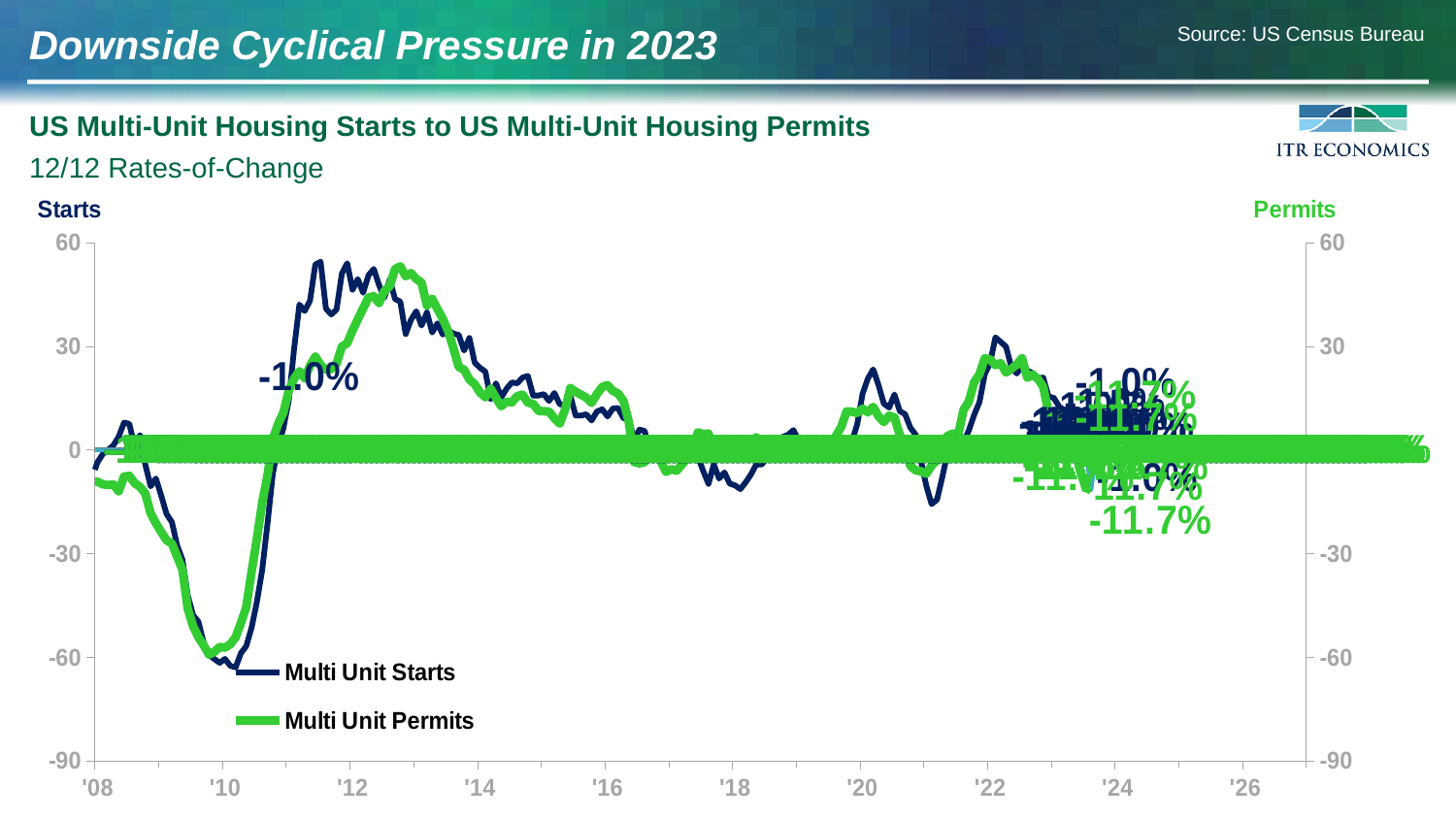
Is the peak value for Multi Unit Permits around 2012-2013 greater or less than 30? greater Does the Multi Unit Starts line rise or fall between 2008 and 2010? fall What kind of chart is shown on the slide? Line chart How many series does the legend list? 2 Does the Multi Unit Permits line rise or fall between 2013 and 2016? fall What is the lowest value shown on the left vertical axis? -90 Is the value for Multi Unit Permits around 2010 greater or less than -30? less What are the two series named in the legend? Multi Unit Starts and Multi Unit Permits Is the value for Multi Unit Starts around 2010 greater or less than -30? less Does the Multi Unit Starts line rise or fall between 2010 and 2012? rise What is the title of the chart? US Multi-Unit Housing Starts to US Multi-Unit Housing Permits